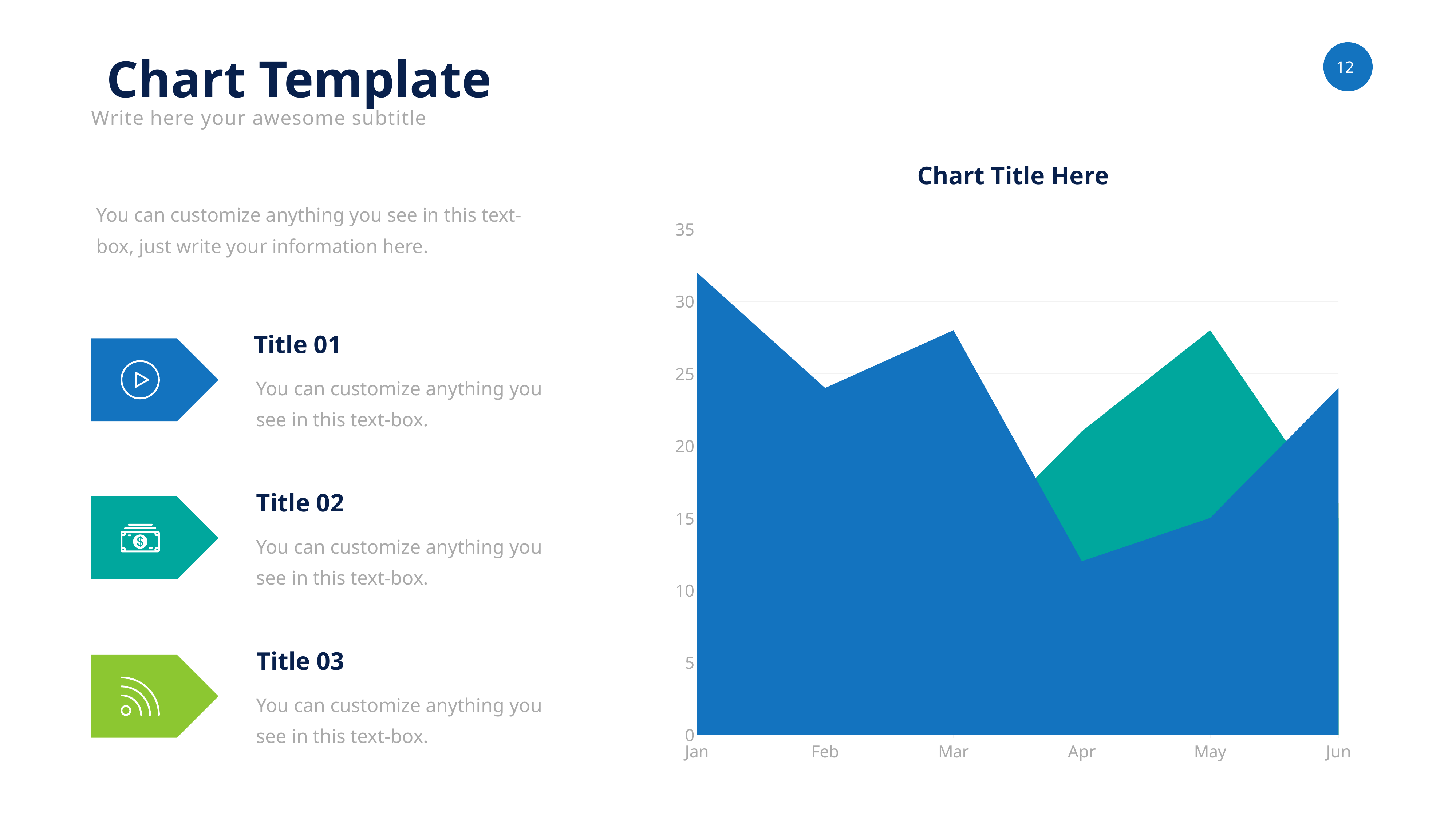
In May, which series has the larger value, the blue series or the teal series? teal series Which is larger for the blue series, the value for Jan or the value for Apr? Jan Is the value of the blue series for Jan greater or less than 30? greater How many months are shown on the x axis of the chart? 6 Which month has the lowest value for the blue series? Apr Which month has the highest value for the blue series? Jan Is the value of the blue series for Mar greater or less than 25? greater Does the blue series rise or fall from Jan to Feb? fall What type of chart is shown on the slide? area chart Is the value of the teal series for May greater or less than 25? greater What is the title of the chart? Chart Title Here